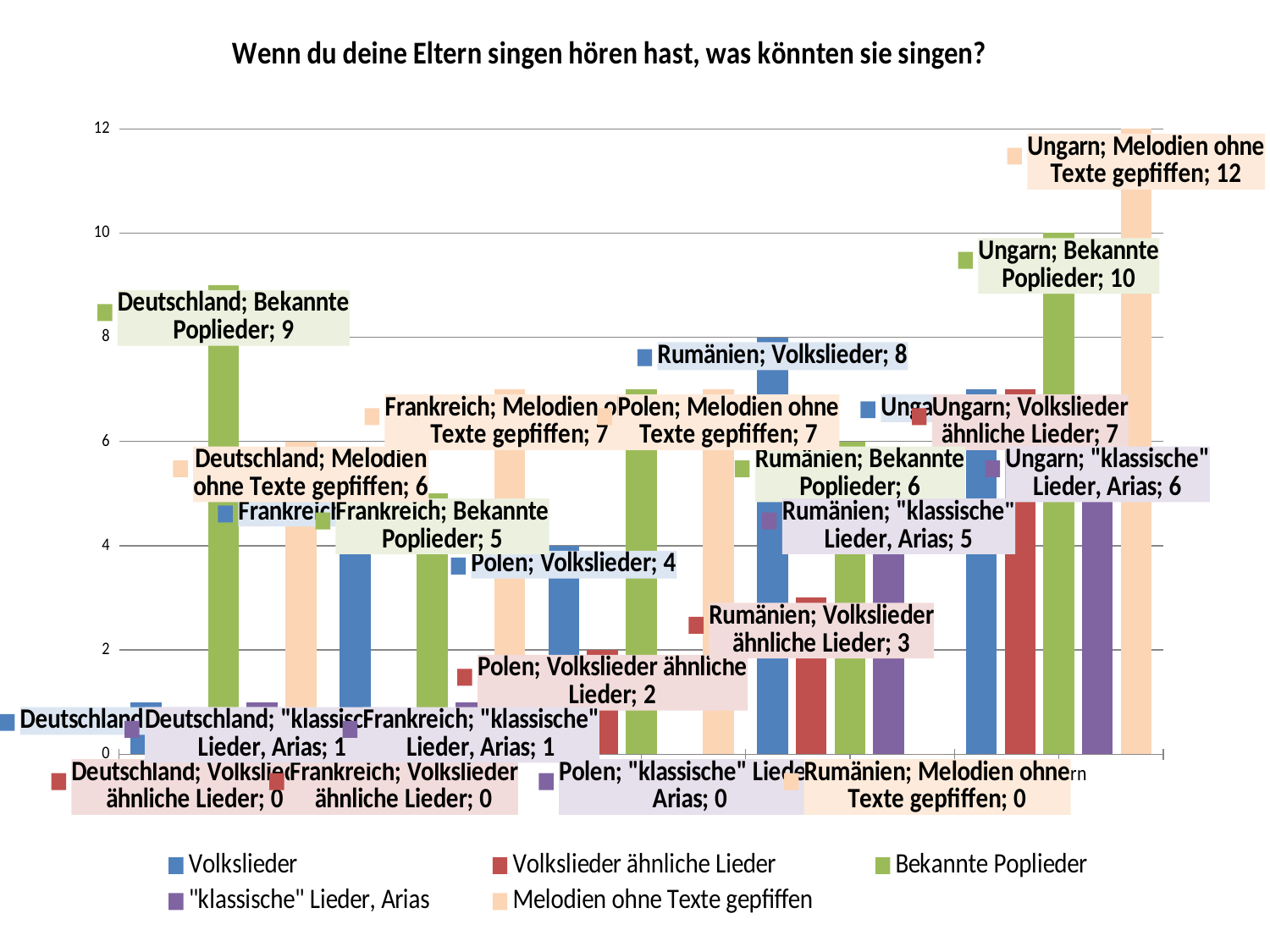
What is the value for Rumänien in the series 'Volkslieder'? 8 What is the value for Deutschland in the series 'Bekannte Poplieder'? 9 Is the value for Ungarn in the series 'Volkslieder' greater or less than 4? greater How many series does the legend list? 5 Which is larger: Rumänien's 'Bekannte Poplieder' value or Rumänien's '"klassische" Lieder, Arias' value? Rumänien's 'Bekannte Poplieder' value What is the difference between Ungarn's 'Melodien ohne Texte gepfiffen' value (12) and Ungarn's 'Bekannte Poplieder' value (10)? 2 Which country has the highest value in the series 'Bekannte Poplieder'? Ungarn What is the value for Polen in the series 'Volkslieder ähnliche Lieder'? 2 What kind of chart is shown on the slide? bar chart What is the value for Rumänien in the series 'Melodien ohne Texte gepfiffen'? 0 What is the title of the chart? Wenn du deine Eltern singen hören hast, was könnten sie singen? What is the value for Ungarn in the series 'Melodien ohne Texte gepfiffen'? 12